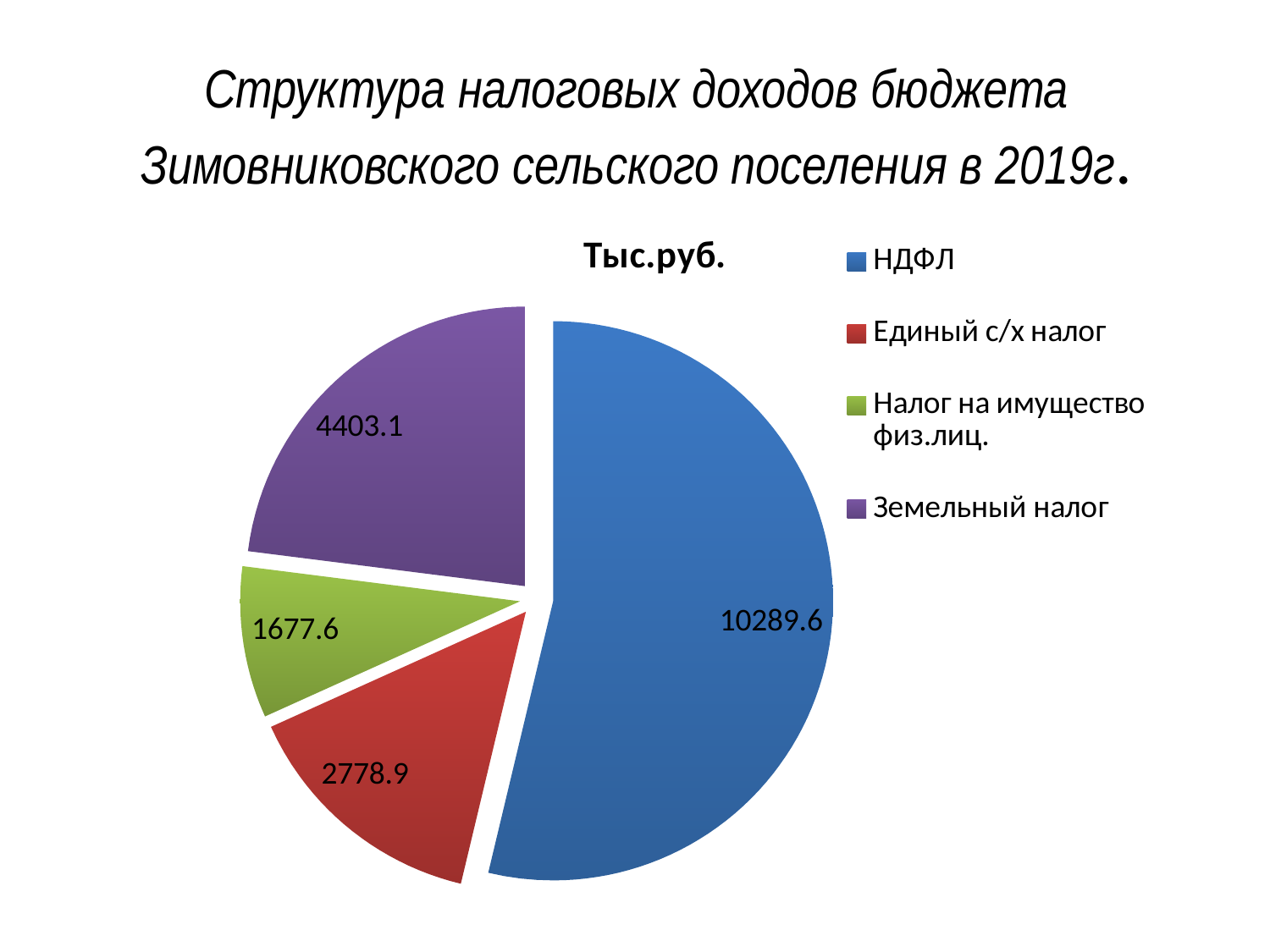
What is the difference between the values for НДФЛ and Земельный налог? 5886.5 Which category has the smallest slice? Налог на имущество физ.лиц. What kind of chart is shown on the slide? Pie chart What is the value for Налог на имущество физ.лиц.? 1677.6 What is the value for Единый с/х налог? 2778.9 How many categories does the pie chart show? 4 Which category has the largest slice? НДФЛ Which is larger, the value for Единый с/х налог or the value for Налог на имущество физ.лиц.? Единый с/х налог What is the value for Земельный налог? 4403.1 What is the title shown above the pie chart? Тыс.руб. What is the value for НДФЛ? 10289.6 What is the difference between the values for Земельный налог and Единый с/х налог? 1624.2